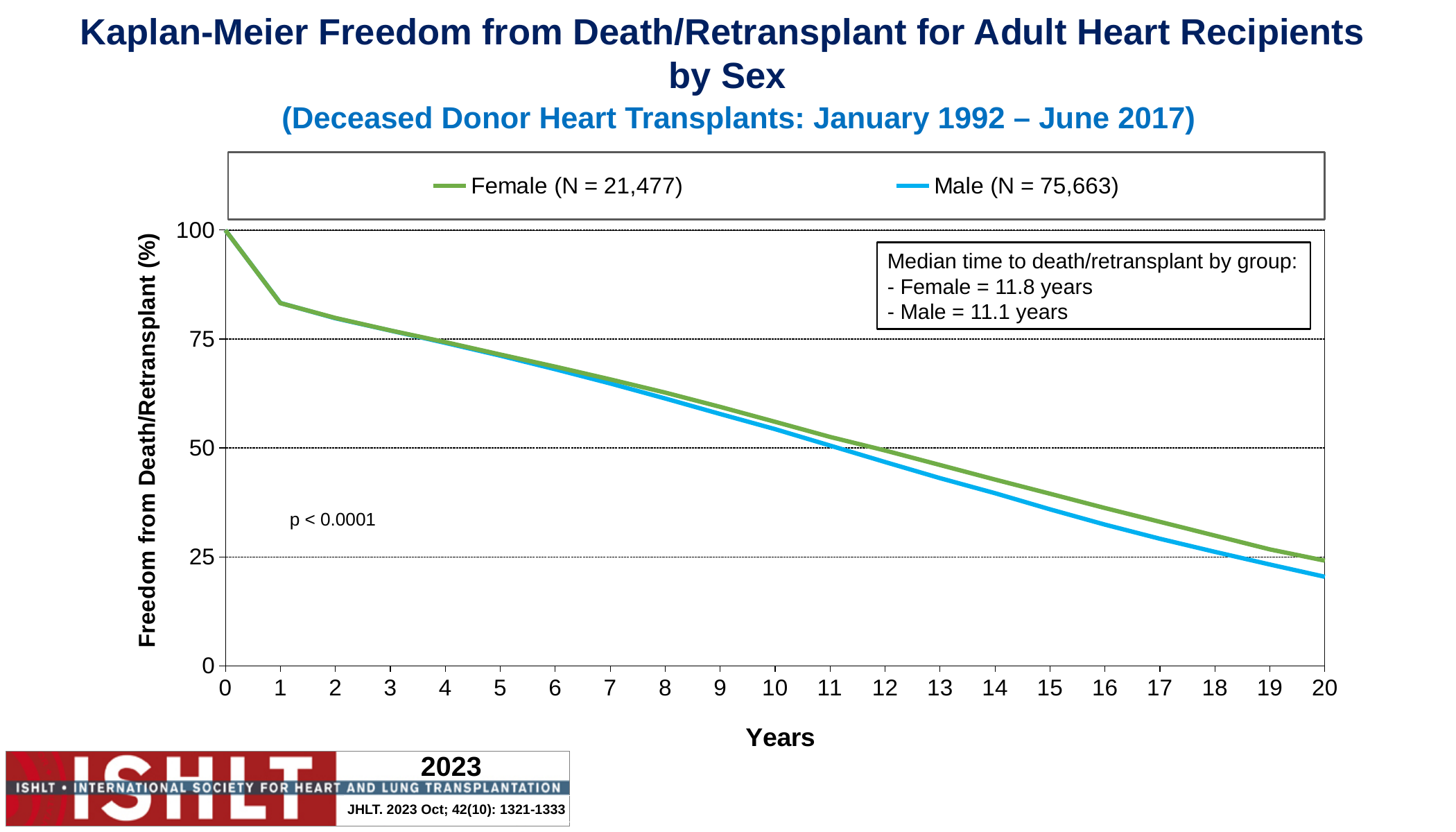
Which group has the longer median time to death/retransplant, Female or Male? Female Is the value for the Female group at year 10 greater or less than 50? greater What is the freedom from death/retransplant value for both groups at year 0? 100 According to the annotation box, what is the median time to death/retransplant for the Male group? 11.1 years Is the value for the Male group at year 20 greater or less than 25? less How many series does the legend list? 2 What is the N for the Male group shown in the legend? 75,663 At year 15, which group has the higher freedom from death/retransplant, Female or Male? Female Do the curves rise or fall as years increase along the x axis? Fall According to the annotation box, what is the median time to death/retransplant for the Female group? 11.8 years What is the difference in median time to death/retransplant between the Female and Male groups? 0.7 years What kind of chart is shown on the slide? Line chart